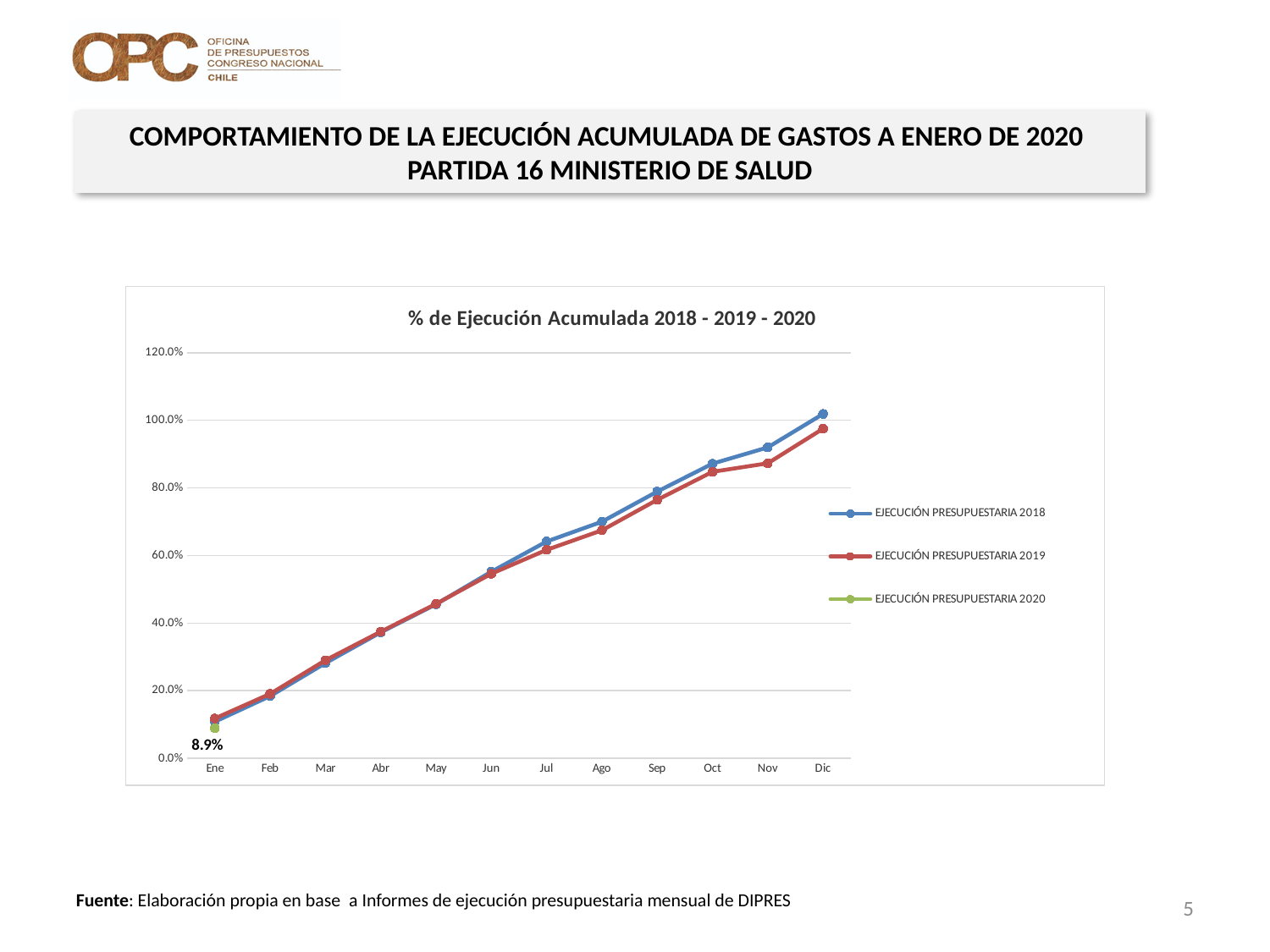
Do the values for EJECUCIÓN PRESUPUESTARIA 2018 rise or fall from Ene to Dic? Rise Is the value for EJECUCIÓN PRESUPUESTARIA 2019 in Sep greater or less than 80.0%? less How many series does the legend list? 3 What is the value labelled for EJECUCIÓN PRESUPUESTARIA 2020 in Ene? 8.9% Is the value for EJECUCIÓN PRESUPUESTARIA 2018 in Oct greater or less than 80.0%? greater In which month is EJECUCIÓN PRESUPUESTARIA 2018 highest? Dic Is the value for EJECUCIÓN PRESUPUESTARIA 2018 in Dic greater or less than 100.0%? greater What type of chart is shown on the slide? Line chart In which month is EJECUCIÓN PRESUPUESTARIA 2019 lowest? Ene In Dic, which series is larger: EJECUCIÓN PRESUPUESTARIA 2018 or EJECUCIÓN PRESUPUESTARIA 2019? EJECUCIÓN PRESUPUESTARIA 2018 How many months are shown on the x axis? 12 What is the title of the chart? % de Ejecución Acumulada 2018 - 2019 - 2020